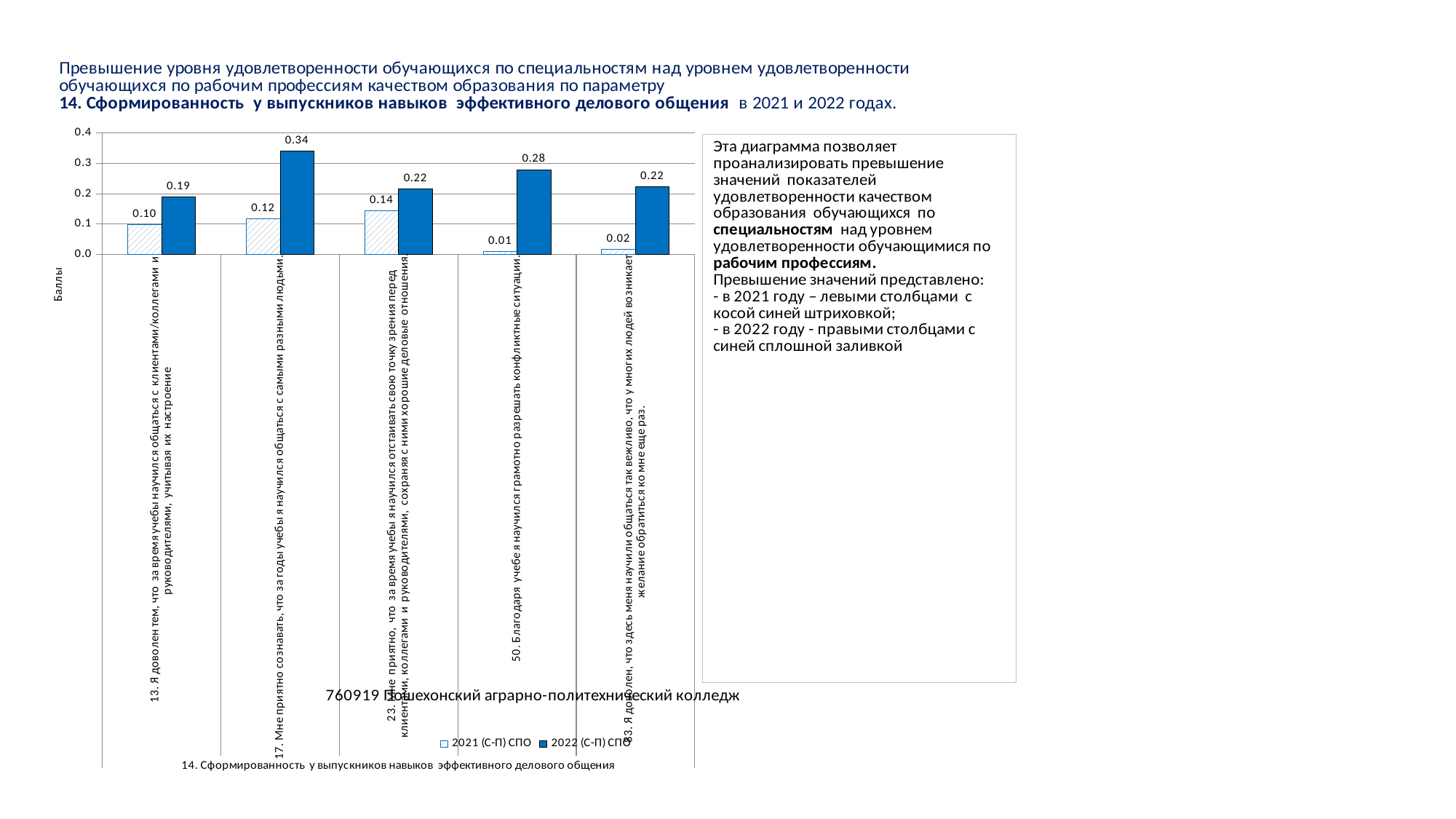
What type of chart is shown on the slide? bar chart What is the difference between the 2022 and 2021 values for statement 50? 0.27 How many categories (statements) are plotted on the chart? 5 How many series does the chart legend list? 2 What is the label of the vertical axis of the chart? Баллы What is the value of the 2021 (С-П) СПО series for statement 50 ("Благодаря учебе я научился грамотно разрешать конфликтные ситуации")? 0.01 For statement 13, which series has the larger value: 2021 (С-П) СПО or 2022 (С-П) СПО? 2022 (С-П) СПО What is the value of the 2022 (С-П) СПО series for statement 17 ("Мне приятно сознавать, что за годы учебы я научился общаться с самыми разными людьми")? 0.34 What is the value of the 2021 (С-П) СПО series for statement 23? 0.14 Which statement has the highest value in the 2022 (С-П) СПО series? 17. Мне приятно сознавать, что за годы учебы я научился общаться с самыми разными людьми Which statement has the lowest value in the 2021 (С-П) СПО series? 50. Благодаря учебе я научился грамотно разрешать конфликтные ситуации